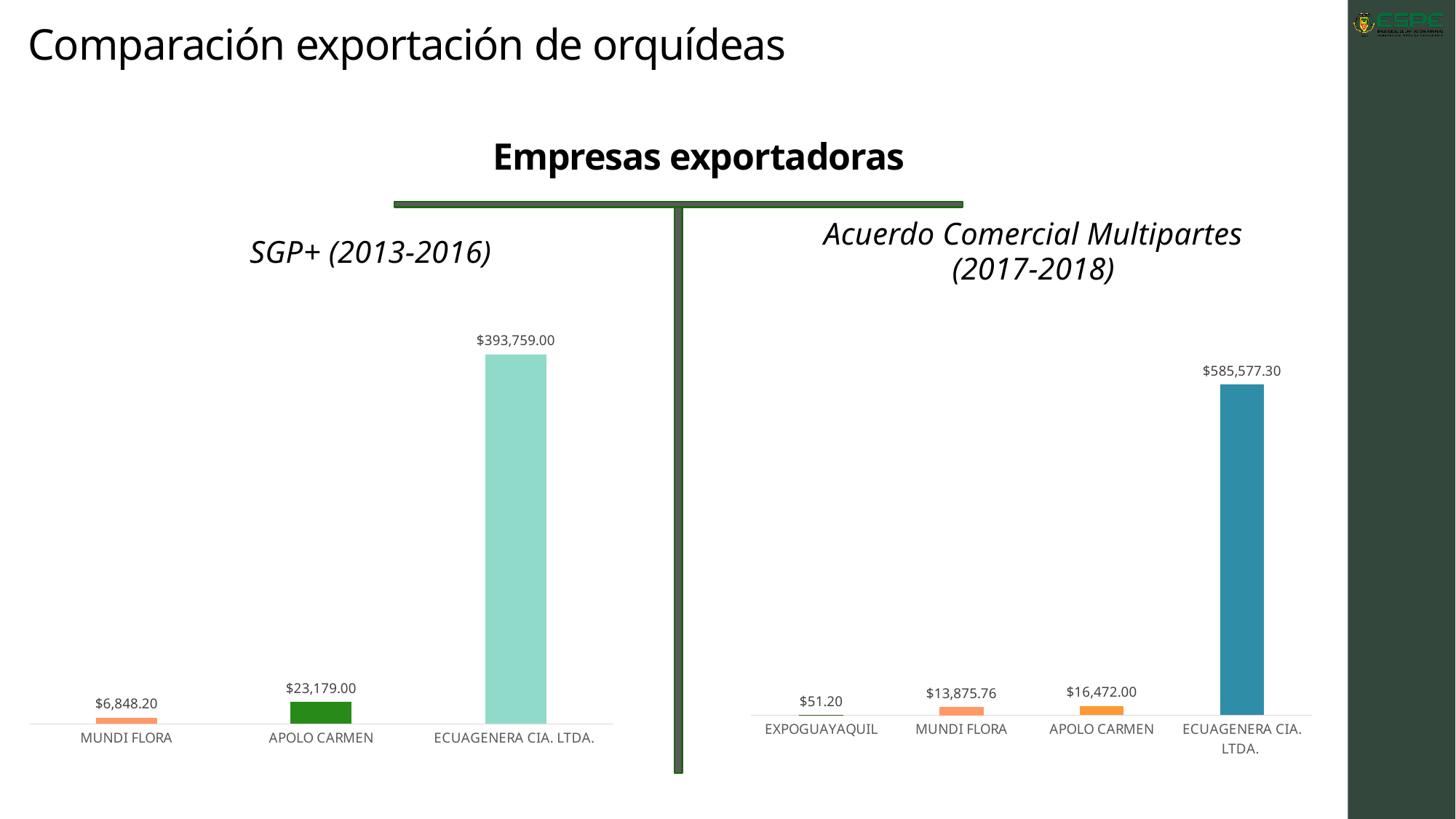
In the Acuerdo Comercial Multipartes (2017-2018) chart, what is the value for APOLO CARMEN? $16,472.00 In the SGP+ (2013-2016) chart, what is the value for ECUAGENERA CIA. LTDA.? $393,759.00 What type of chart is the SGP+ (2013-2016) chart? Bar chart Which is larger: the value for ECUAGENERA CIA. LTDA. in the SGP+ (2013-2016) chart or in the Acuerdo Comercial Multipartes (2017-2018) chart? Acuerdo Comercial Multipartes (2017-2018) In the Acuerdo Comercial Multipartes (2017-2018) chart, what is the difference between APOLO CARMEN and MUNDI FLORA? $2,596.24 In the Acuerdo Comercial Multipartes (2017-2018) chart, which company has the lowest value? EXPOGUAYAQUIL In the Acuerdo Comercial Multipartes (2017-2018) chart, what is the value for EXPOGUAYAQUIL? $51.20 In the SGP+ (2013-2016) chart, what is the difference between APOLO CARMEN and MUNDI FLORA? $16,330.80 In the Acuerdo Comercial Multipartes (2017-2018) chart, which company has the highest value? ECUAGENERA CIA. LTDA. How many companies are shown in the Acuerdo Comercial Multipartes (2017-2018) chart? 4 In the SGP+ (2013-2016) chart, which company has the lowest value? MUNDI FLORA In the SGP+ (2013-2016) chart, what is the value for MUNDI FLORA? $6,848.20